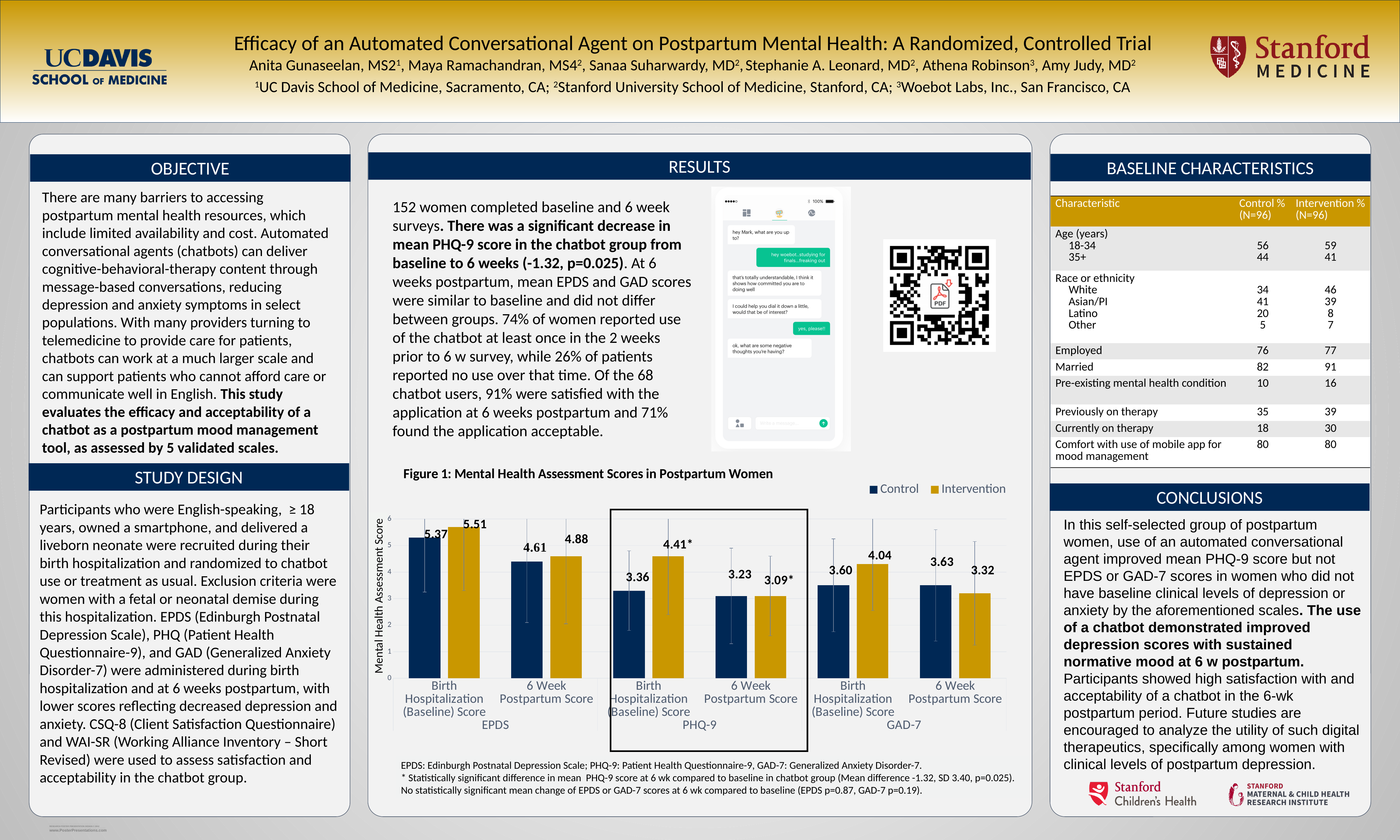
Which is larger for the GAD-7 6 Week Postpartum Score, Control or Intervention? Control Is the Control value for the EPDS 6 Week Postpartum Score greater or less than 4? greater What is the title of the chart? Figure 1: Mental Health Assessment Scores in Postpartum Women What is the Intervention value for the PHQ-9 Birth Hospitalization (Baseline) Score? 4.41 What is the difference between the Intervention and Control values for the PHQ-9 Birth Hospitalization (Baseline) Score? 1.05 What is the Intervention value for the GAD-7 6 Week Postpartum Score? 3.32 How many series does the legend list? 2 Which category has the highest Intervention value? EPDS Birth Hospitalization (Baseline) Score Which category has the lowest Intervention value? PHQ-9 6 Week Postpartum Score What kind of chart is Figure 1? Bar chart Does the Intervention PHQ-9 score rise or fall from Birth Hospitalization (Baseline) to 6 Week Postpartum? Fall What is the Control value for the EPDS Birth Hospitalization (Baseline) Score? 5.37